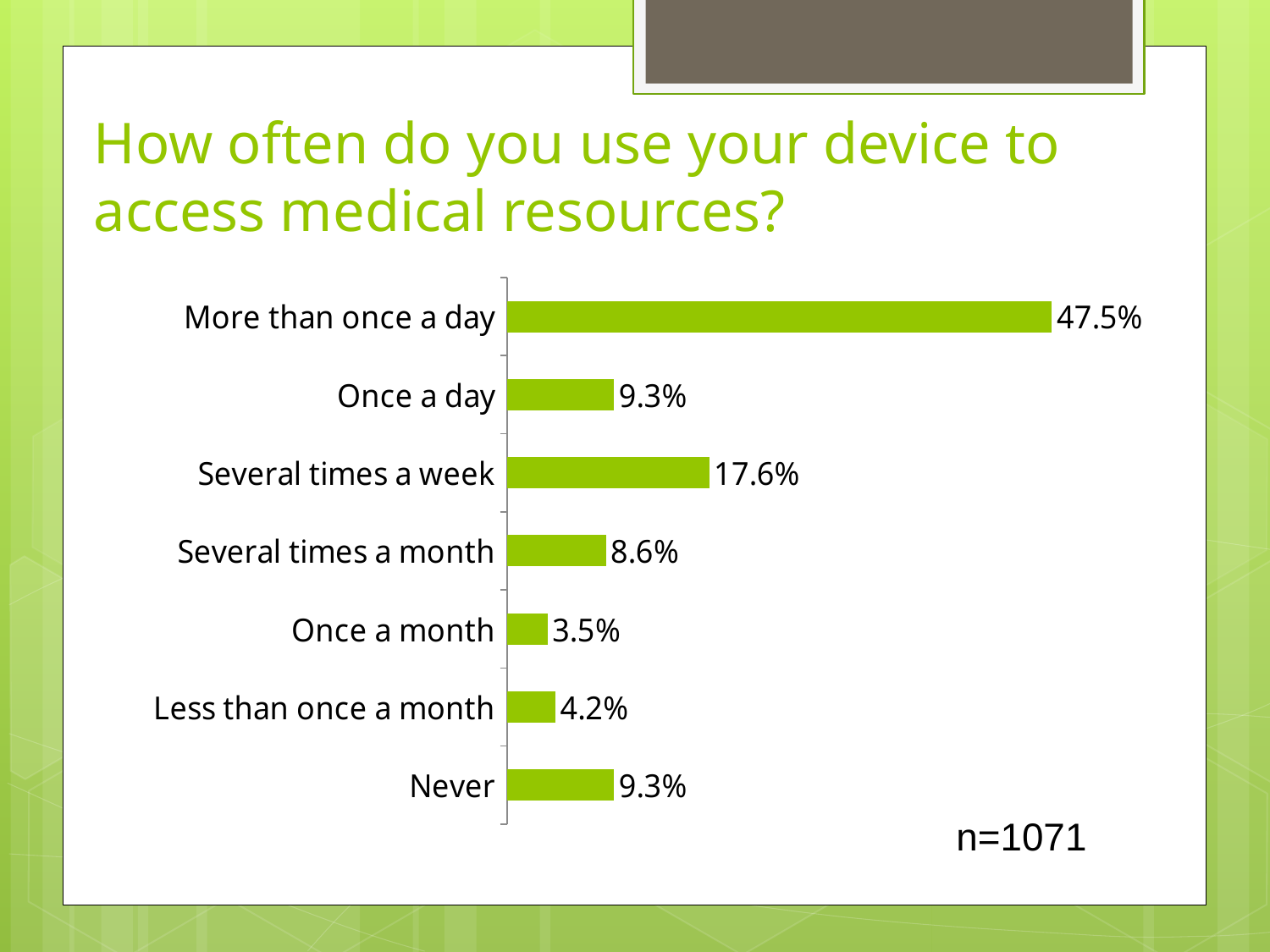
What percentage of respondents use their device to access medical resources more than once a day? 47.5% Which category has the highest value? More than once a day Which category has the lowest value? Once a month What is the difference between 'Several times a month' and 'Less than once a month'? 4.4% What sample size (n) is shown on the slide? n=1071 What percentage of respondents answered 'Never'? 9.3% What is the value for 'Once a month'? 3.5% How many categories are shown in the chart? 7 What is the value for 'Several times a week'? 17.6% What is the difference between 'More than once a day' and 'Several times a week'? 29.9% What kind of chart is shown on the slide? Bar chart Which is larger: 'Several times a week' or 'Once a day'? Several times a week